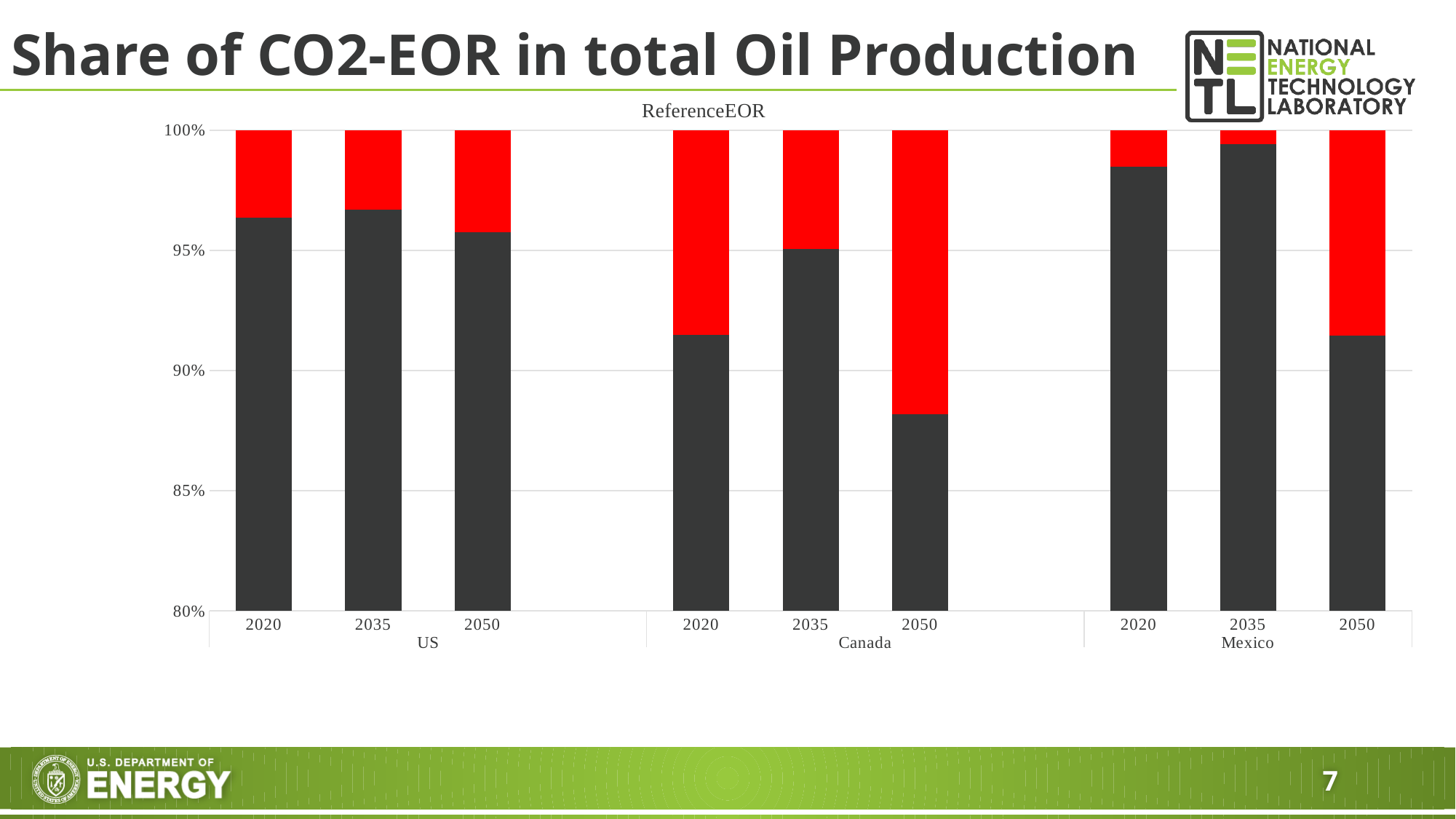
Is the dark segment for Canada 2050 greater or less than 90%? less Which has the larger dark segment, Mexico 2035 or Canada 2035? Mexico 2035 Is the dark segment for Mexico 2020 greater or less than 95%? greater Is the dark segment for Mexico 2050 greater or less than 95%? less Which bar has the smallest red segment? Mexico 2035 What kind of chart is shown on the slide? stacked bar chart Which has the larger red segment, Canada 2020 or US 2020? Canada 2020 How many country groups are shown on the x axis? 3 What is the title printed above the chart? ReferenceEOR How many bars are plotted in the chart? 9 Which bar has the largest red segment? Canada 2050